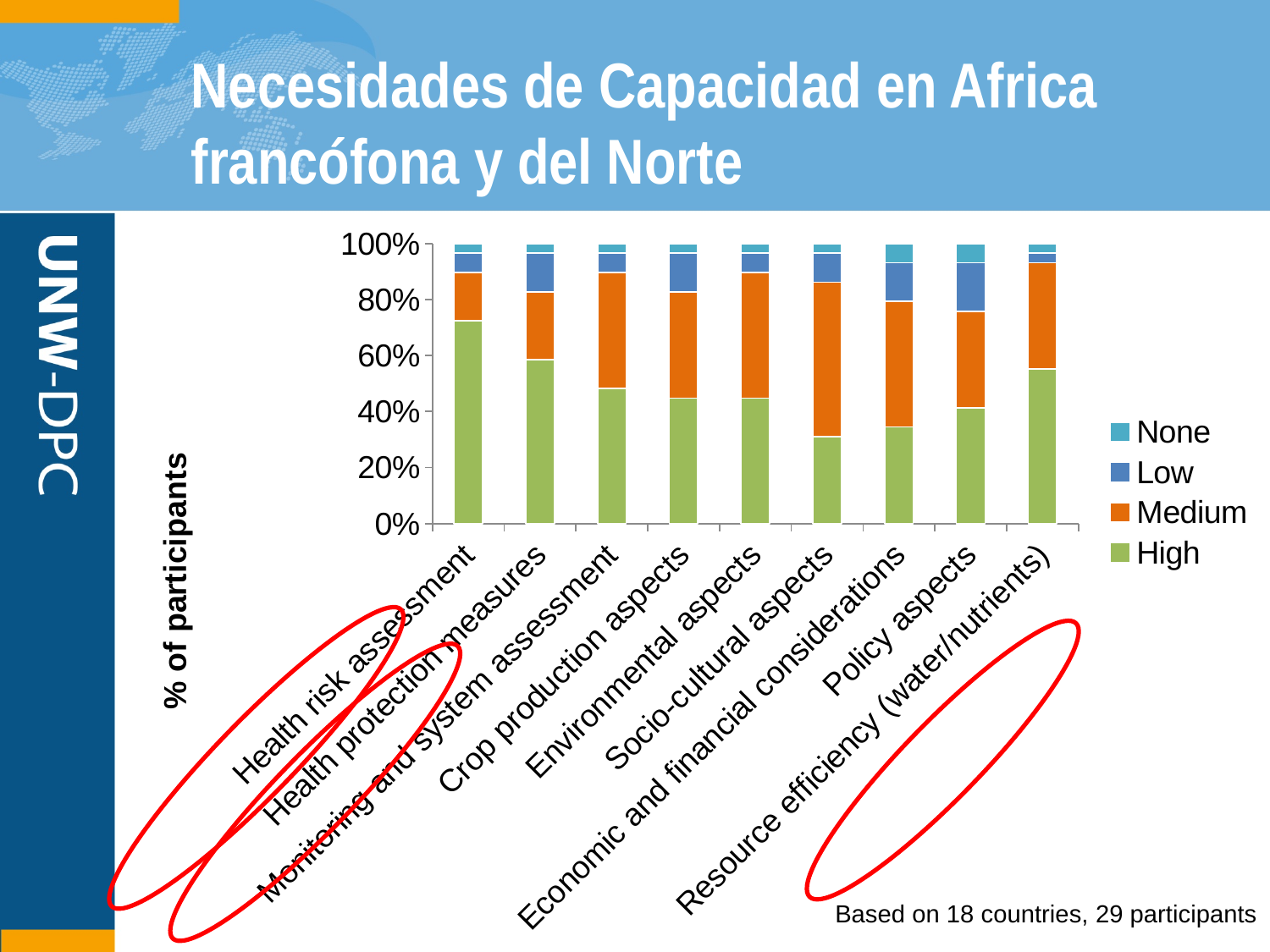
Is the 'High' value for Health risk assessment greater or less than 60%? greater Which has a larger 'High' share: Health risk assessment or Socio-cultural aspects? Health risk assessment How many categories are shown along the x axis? 9 What is the label of the y axis? % of participants What kind of chart is shown on the slide? Stacked bar chart How many series does the legend list? 4 Is the 'High' value for Policy aspects greater or less than 50%? less Which category has the highest share of participants rating it 'High'? Health risk assessment Is the 'High' value for Resource efficiency (water/nutrients) greater or less than 40%? greater Which has a larger 'High' share: Health protection measures or Crop production aspects? Health protection measures What does each stacked bar total on the y axis? 100%